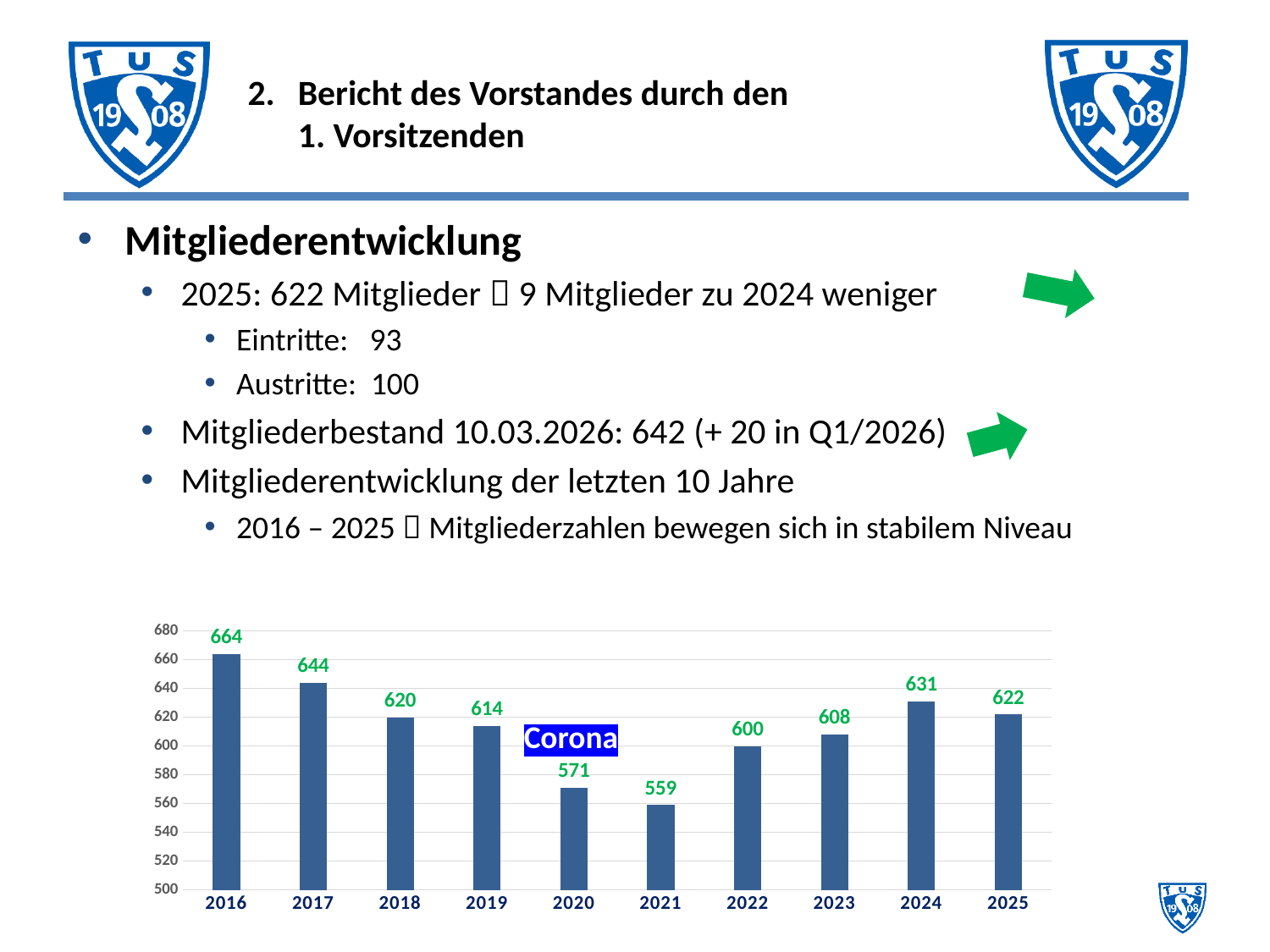
What kind of chart is shown on the slide? bar chart What is the value for 2020? 571 Is the value for 2021 greater or less than 560? less How many years are shown on the x axis? 10 What is the value for 2016? 664 Which year has the lowest value? 2021 What is the difference between the values for 2024 and 2025? 9 Do the values rise or fall from 2016 to 2021? fall What is the value for 2025? 622 Which year has the highest value? 2016 What is the difference between the values for 2016 and 2021? 105 Which is larger, the value for 2022 or the value for 2023? 2023